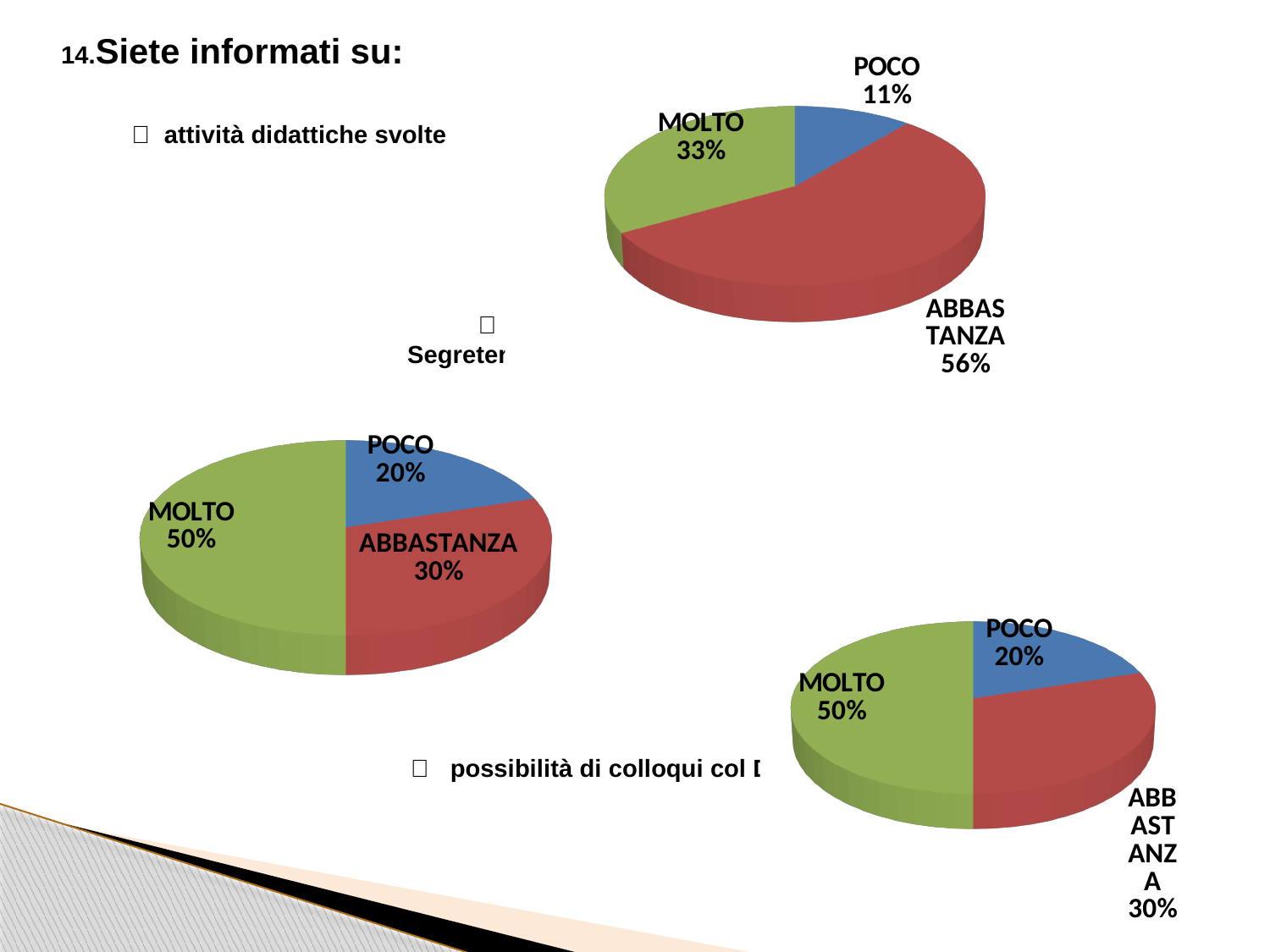
In the pie chart at the bottom right of the slide, what share is labelled ABBASTANZA? 30% In the pie chart at the top right of the slide, what share is labelled POCO? 11% What type of chart is the chart at the bottom right of the slide? Pie chart In the pie chart on the middle left of the slide, what share is labelled MOLTO? 50% In the pie chart at the top right of the slide, what is the difference between the ABBASTANZA and MOLTO shares? 23% In the pie chart at the top right of the slide, what share is labelled ABBASTANZA? 56% In the pie chart at the bottom right of the slide, which category has the largest slice? MOLTO In the pie chart on the middle left of the slide, which is larger, ABBASTANZA or POCO? ABBASTANZA In the pie chart at the top right of the slide, which category has the largest slice? ABBASTANZA In the pie chart on the middle left of the slide, how many slices are there? 3 How many pie charts are shown on the slide? 3 In the pie chart at the top right of the slide, which category has the smallest slice? POCO